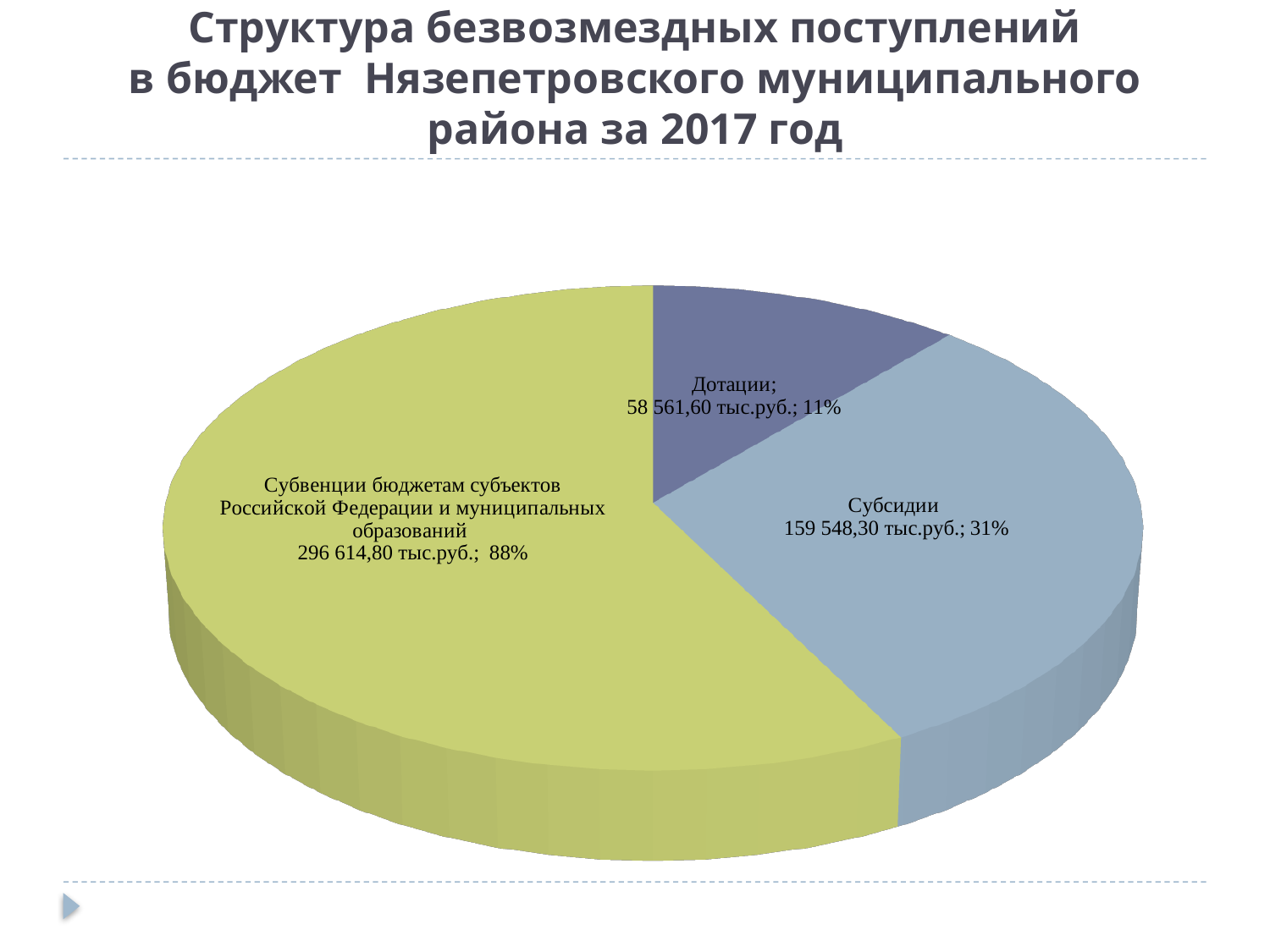
What share of the pie is labelled for Дотации? 11% What is the value for Субсидии? 159 548,30 тыс.руб. What share of the pie is labelled for Субсидии? 31% What is the difference between the values for Субсидии and Дотации? 100 986,70 тыс.руб. Which category has the largest slice? Субвенции бюджетам субъектов Российской Федерации и муниципальных образований What colour is the Дотации slice? dark blue-purple Which category has the smallest slice? Дотации How many slices does the pie chart have? 3 What is the value for Субвенции бюджетам субъектов Российской Федерации и муниципальных образований? 296 614,80 тыс.руб. What is the value for Дотации? 58 561,60 тыс.руб. What kind of chart is shown on the slide? pie chart Which is larger, Субсидии or Дотации? Субсидии